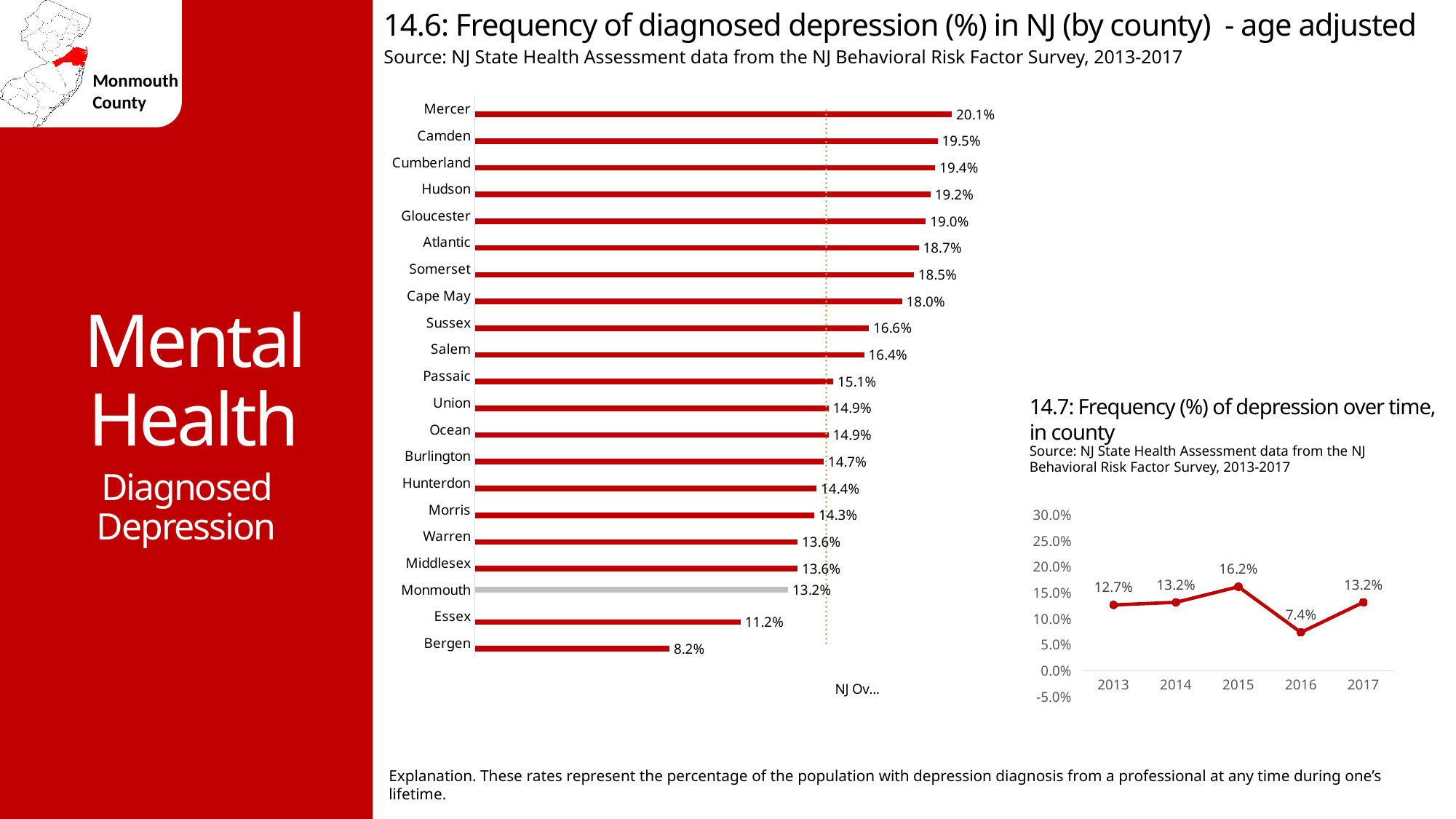
In chart 14.7, what is the frequency of depression in 2016? 7.4% In chart 14.6, which county has the lowest frequency of diagnosed depression? Bergen In chart 14.6, what is the frequency of diagnosed depression for Monmouth County? 13.2% What kind of chart is chart 14.6? Bar chart In chart 14.6, which county has a higher value, Hudson or Cape May? Hudson In chart 14.7, how many years are plotted? 5 In chart 14.6, what is the difference between Mercer's value and Bergen's value? 11.9% In chart 14.6, what is the value for Essex? 11.2% In chart 14.7, which year has the highest frequency of depression? 2015 In chart 14.7, what is the difference between the 2015 value and the 2016 value? 8.8% In chart 14.6, which county has the highest frequency of diagnosed depression? Mercer In chart 14.6, how many counties are shown? 21